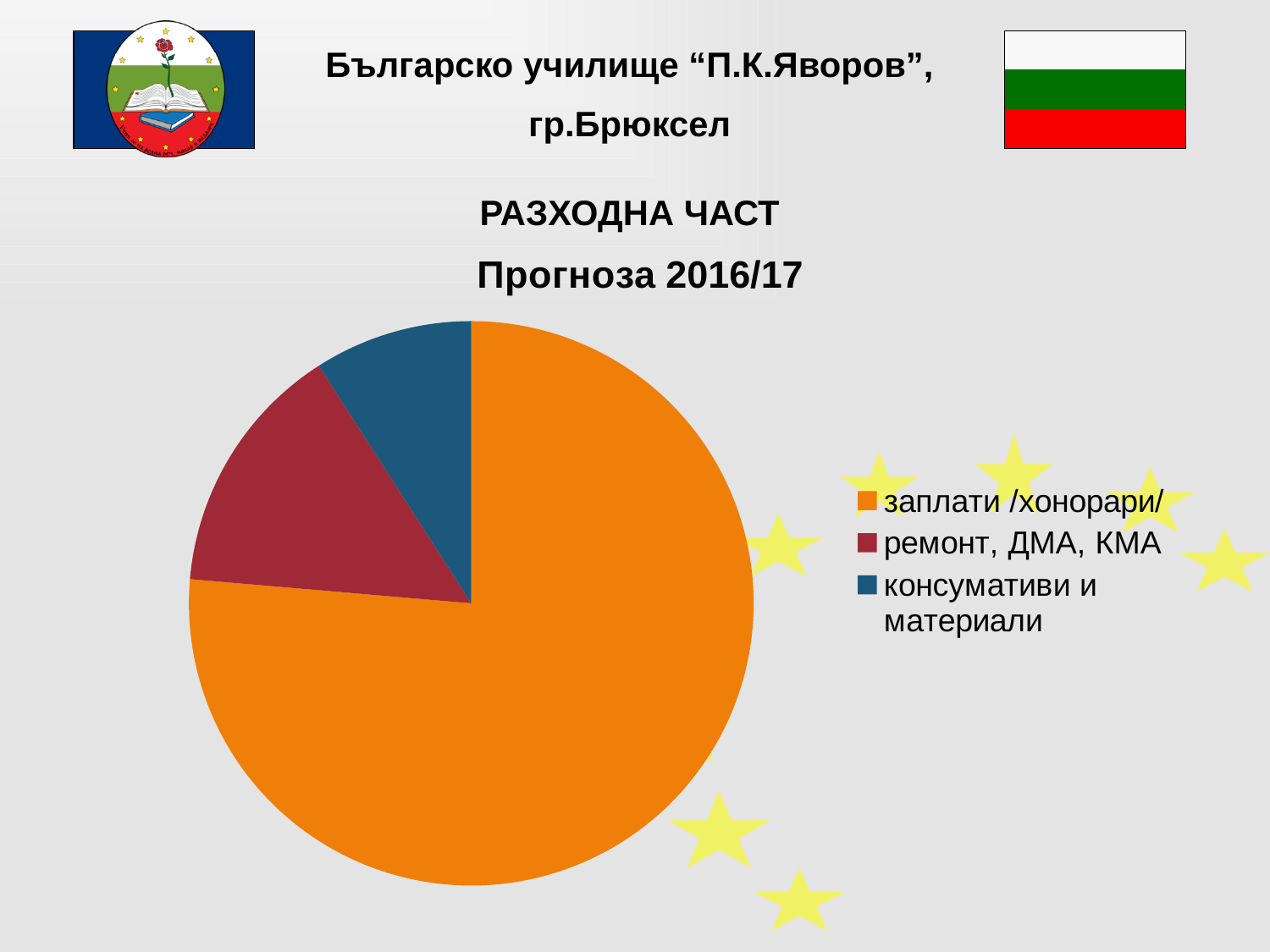
What colour is the slice for заплати /хонорари/? orange What kind of chart is shown on the slide? pie chart Which category has the largest slice of the pie chart? заплати /хонорари/ Which category has the smallest slice of the pie chart? консумативи и материали Which slice is larger: ремонт, ДМА, КМА or консумативи и материали? ремонт, ДМА, КМА How many entries does the legend of the pie chart list? 3 Which slice is larger: заплати /хонорари/ or ремонт, ДМА, КМА? заплати /хонорари/ How many slices does the pie chart have? 3 What is the title of the chart? Прогноза 2016/17